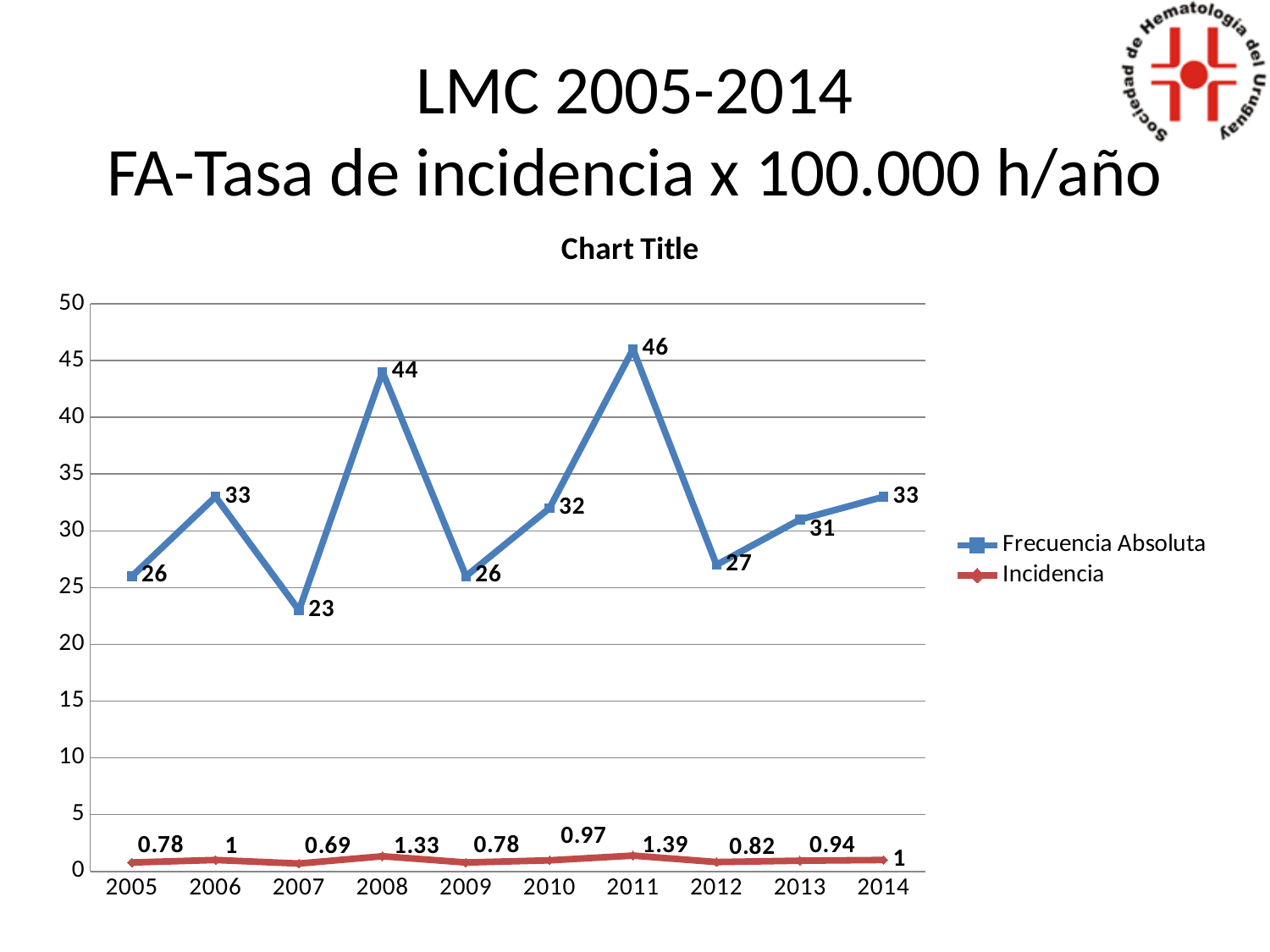
How many series does the legend list? 2 In which year is Frecuencia Absoluta highest? 2011 What is the Incidencia value for 2011? 1.39 Which year has a larger Frecuencia Absoluta value, 2006 or 2010? 2006 What kind of chart is shown? line chart What is the difference between the Frecuencia Absoluta values for 2011 and 2012? 19 How many years are shown on the x axis? 10 Is the Frecuencia Absoluta value for 2013 greater or less than 30? greater In which year is Incidencia lowest? 2007 What is the Frecuencia Absoluta value for 2008? 44 What is the Frecuencia Absoluta value for 2007? 23 Does Frecuencia Absoluta rise or fall from 2012 to 2014? rise